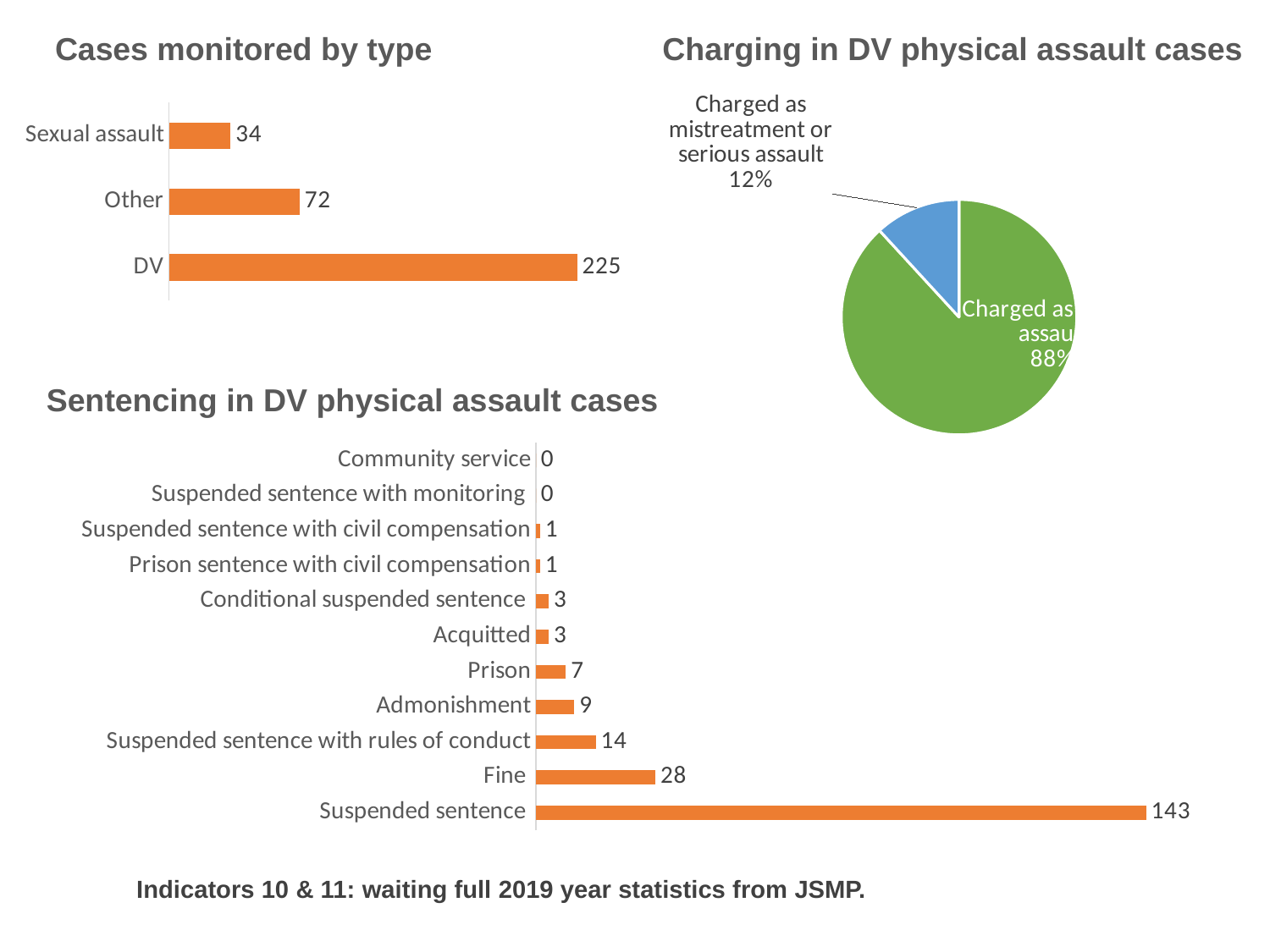
In the 'Sentencing in DV physical assault cases' chart, how many categories are listed? 11 In the 'Charging in DV physical assault cases' chart, what share of cases were charged as mistreatment or serious assault? 12% In the 'Sentencing in DV physical assault cases' chart, what is the value for Fine? 28 In the 'Sentencing in DV physical assault cases' chart, which is larger: Admonishment or Prison? Admonishment In the 'Cases monitored by type' chart, what is the value for DV? 225 In the 'Cases monitored by type' chart, what is the difference between the DV and Other values? 153 What kind of chart is 'Sentencing in DV physical assault cases'? Bar chart In the 'Sentencing in DV physical assault cases' chart, which category has the highest value? Suspended sentence In the 'Sentencing in DV physical assault cases' chart, what is the difference between Suspended sentence and Fine? 115 In the 'Cases monitored by type' chart, how many categories are shown? 3 What kind of chart is 'Charging in DV physical assault cases'? Pie chart In the 'Cases monitored by type' chart, which category has the lowest value? Sexual assault